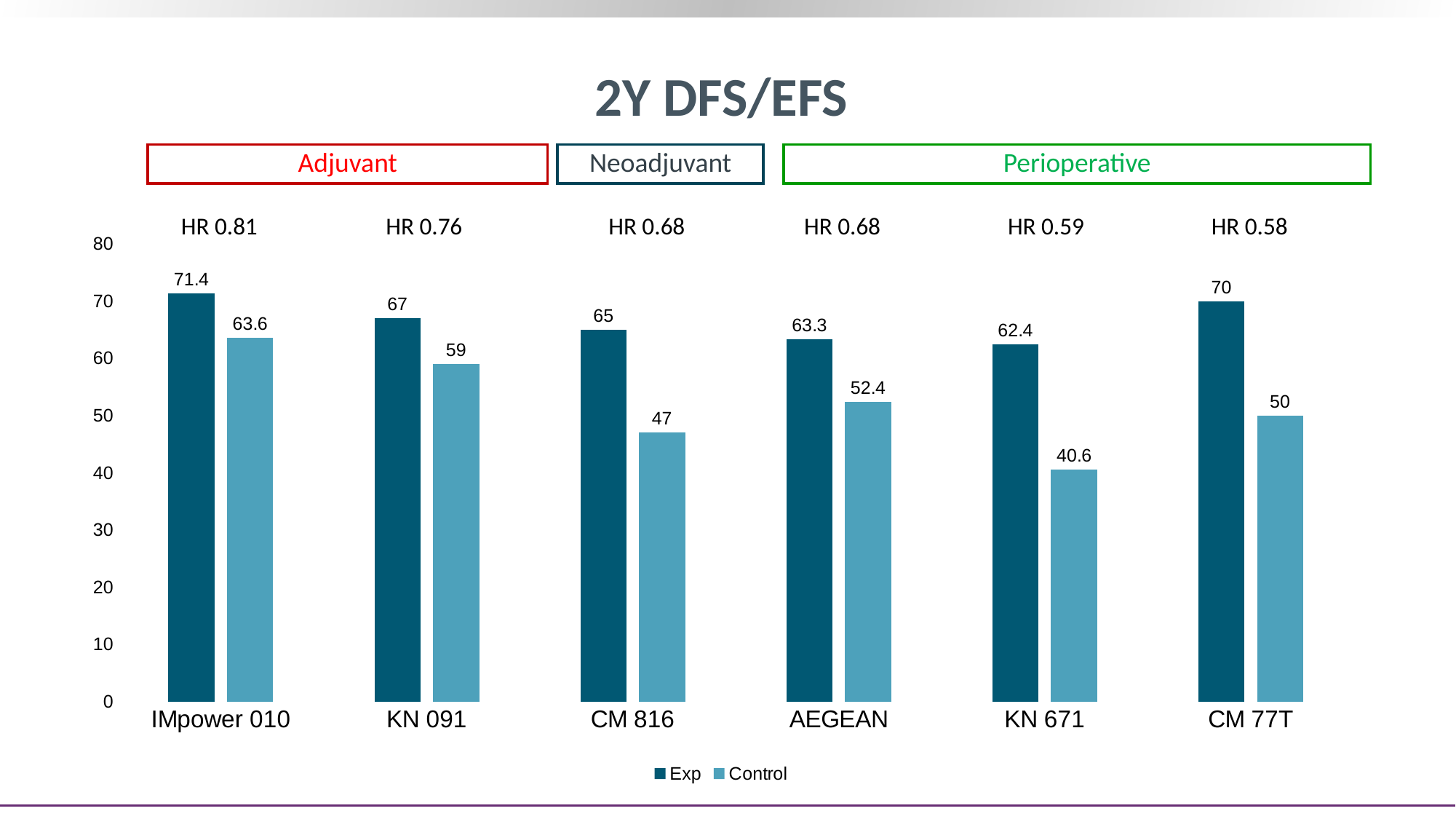
Which is larger, the Control value for KN 091 or the Control value for CM 77T? KN 091 What is the difference between the Exp and Control values for CM 77T? 20 What is the Control value for KN 671? 40.6 How many series does the legend list? 2 What is the Control value for AEGEAN? 52.4 What is the title of the chart? 2Y DFS/EFS What is the Exp value for IMpower 010? 71.4 What is the difference between the Exp and Control values for CM 816? 18 How many trials are shown on the x axis? 6 What kind of chart is shown? bar chart Which trial has the highest Exp value? IMpower 010 Which trial has the lowest Control value? KN 671